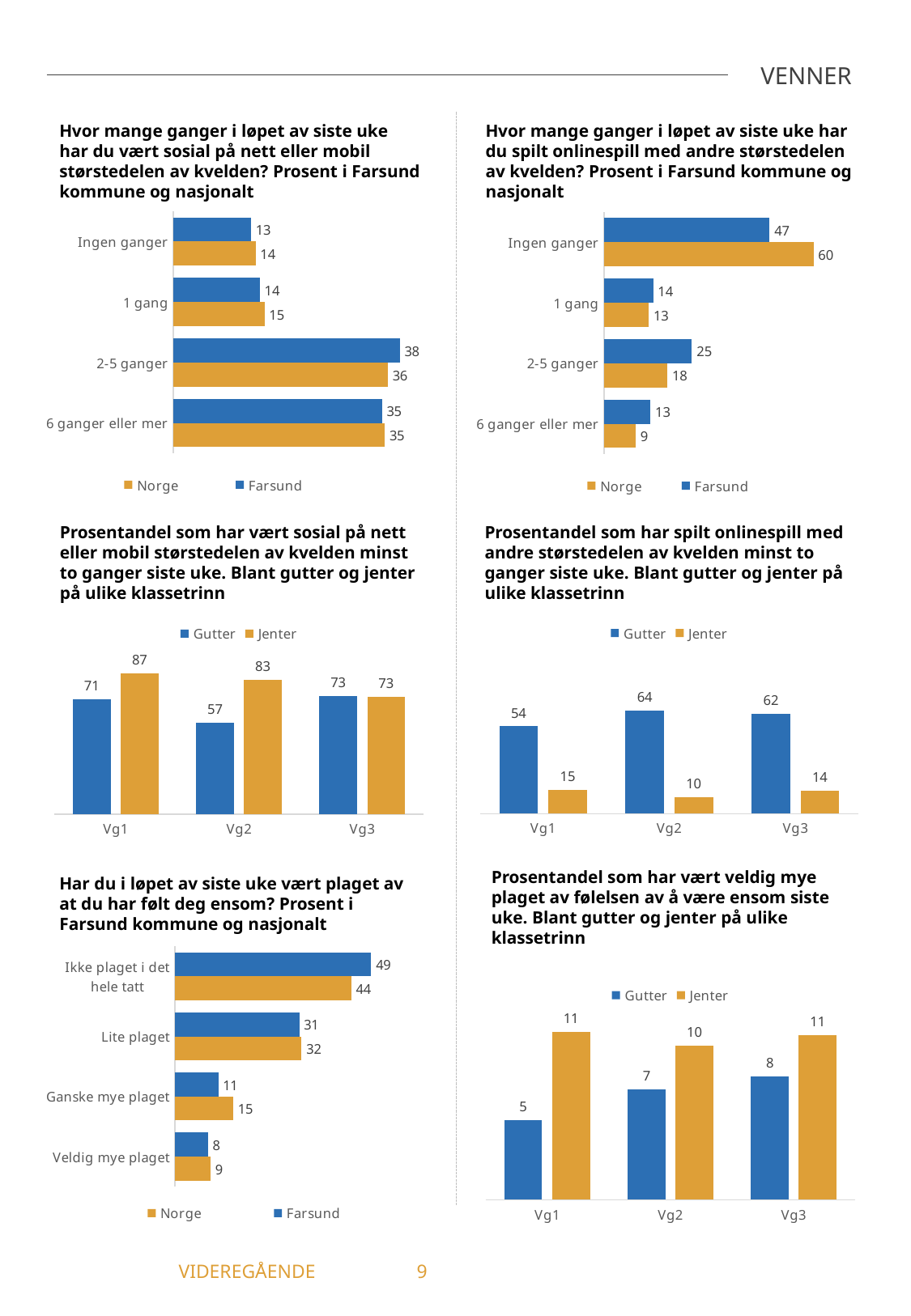
In the middle-left chart (social online at least twice last week, by gender and grade), which grade has the lowest Gutter value? Vg2 In the bottom-left chart (bothered by feeling lonely), how many categories are shown? 4 In the middle-left chart (social online at least twice last week, by gender and grade), what is the Jenter value for Vg1? 87 In the top-right chart (played online games most of the evening), what is the difference between the Norge and Farsund values for 'Ingen ganger'? 13 In the top-left chart (social online or on mobile most of the evening), what is the Farsund value for '2-5 ganger'? 38 In the top-right chart (played online games most of the evening), what is the Farsund value for '6 ganger eller mer'? 13 In the top-right chart (played online games most of the evening), which category has the highest Norge value? Ingen ganger In the top-left chart (social online or on mobile most of the evening), what is the Norge value for 'Ingen ganger'? 14 In the middle-right chart (played online games at least twice last week, by gender and grade), which is larger for Vg2: Gutter or Jenter? Gutter In the middle-right chart (played online games at least twice last week, by gender and grade), what is the Jenter value for Vg3? 14 In the bottom-right chart (very much bothered by loneliness, by gender and grade), what is the Gutter value for Vg1? 5 In the bottom-left chart (bothered by feeling lonely), what is the Norge value for 'Ganske mye plaget'? 15